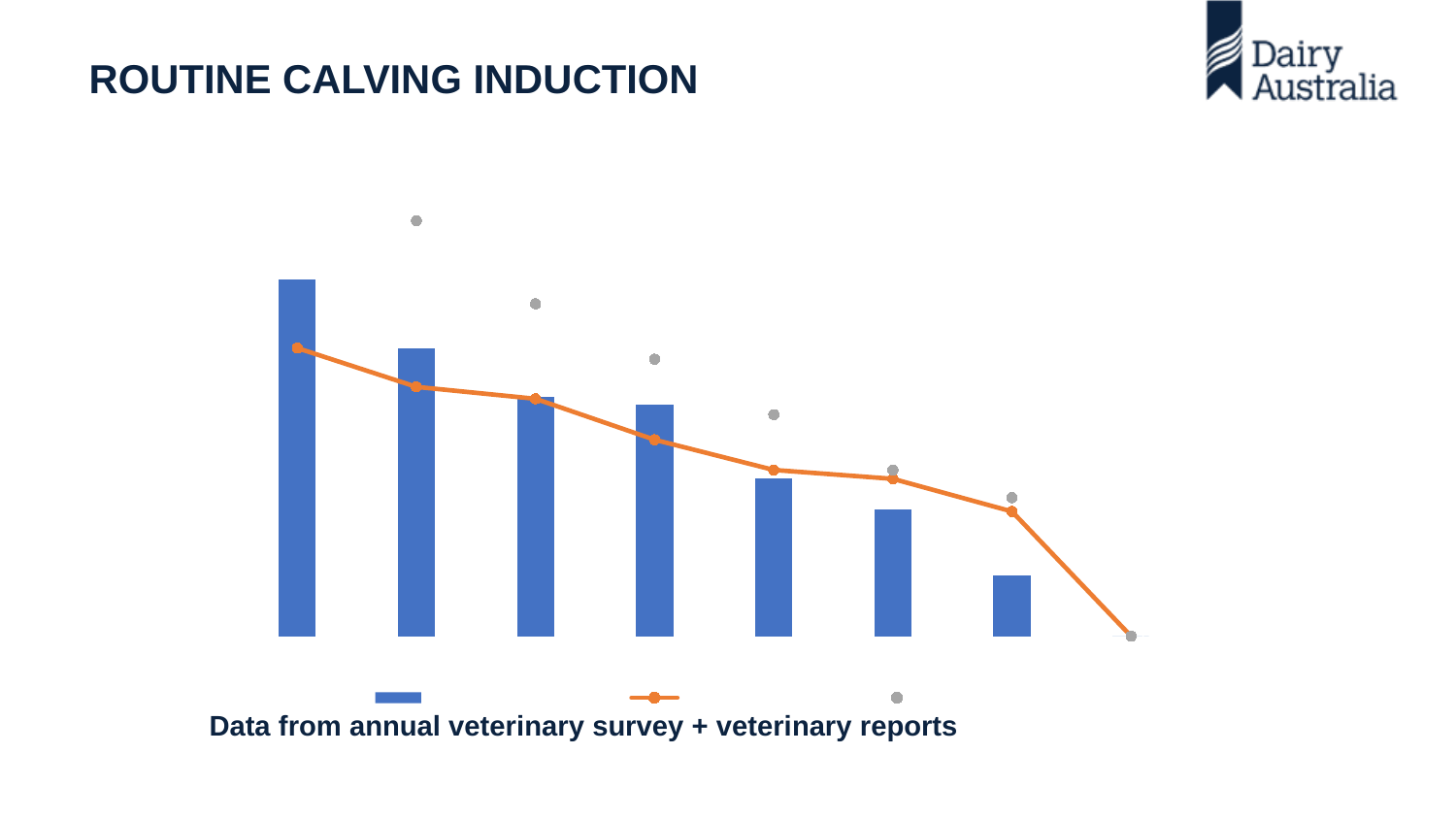
What kind of chart is shown on the slide? A combined bar and line chart How many series does the legend show? 3 Does the orange line rise or fall from left to right? Fall How many bars are plotted in the chart? 7 How many grey dots are plotted in the chart? 7 Which bar is the tallest? The leftmost (first) bar Do the bar values rise or fall from left to right? Fall What colour are the bars in the chart? Blue How many points are plotted on the orange line? 8 Is the first bar taller or shorter than the second bar? Taller Which bar is the shortest? The rightmost (seventh) bar What is the title of the slide containing the chart? ROUTINE CALVING INDUCTION